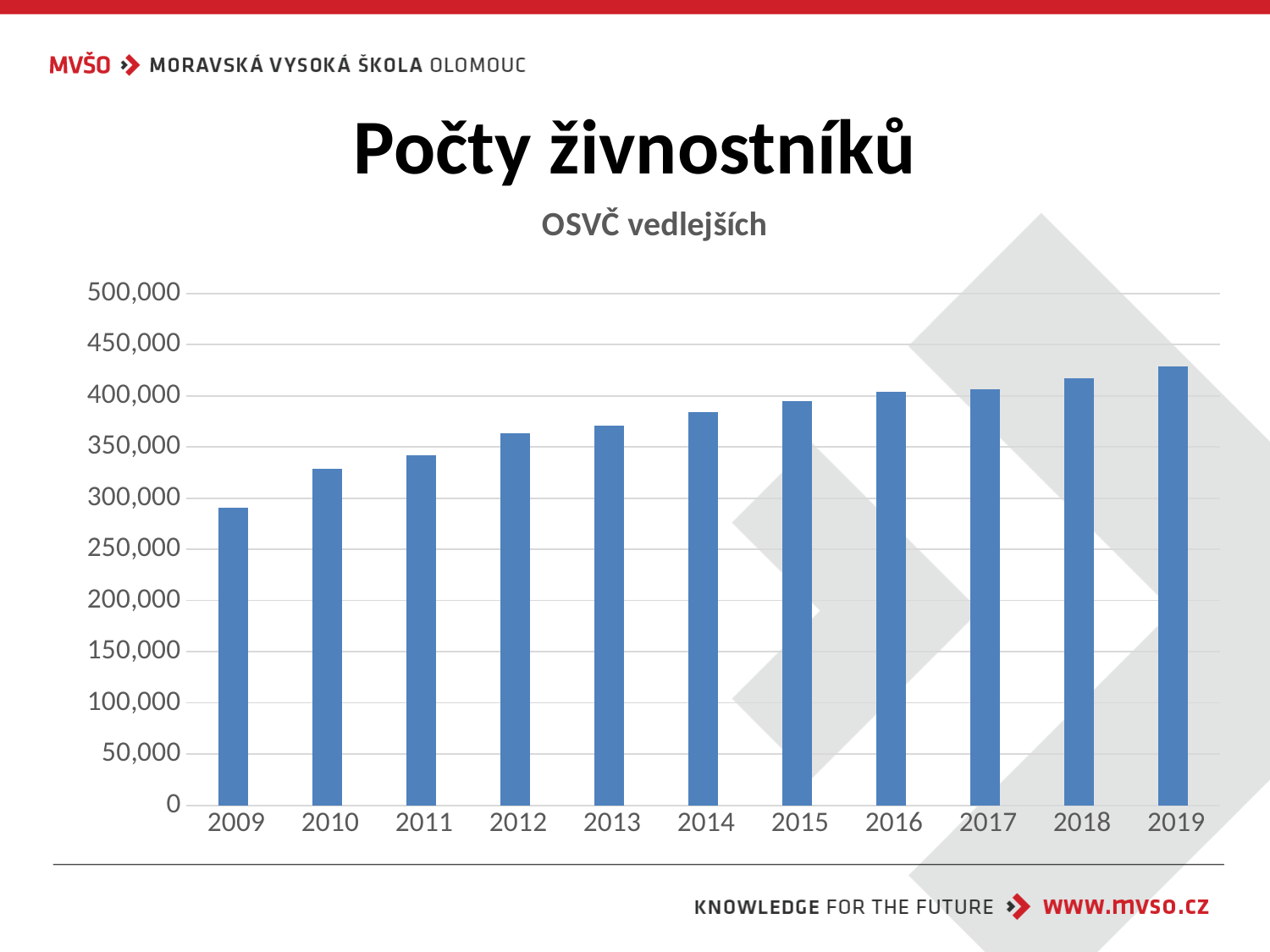
Do the values generally rise or fall from 2009 to 2019? rise Is the value for 2015 greater or less than 400,000? less How many years are shown on the x axis of the chart? 11 What is the title of the chart? OSVČ vedlejších Which year has the highest value in the chart? 2019 Is the value for 2012 greater or less than 350,000? greater Is the value for 2009 greater or less than 300,000? less Which is larger, the value for 2010 or the value for 2014? 2014 Which year has the lowest value in the chart? 2009 What kind of chart is shown on the slide? bar chart What colour are the bars in the chart? blue